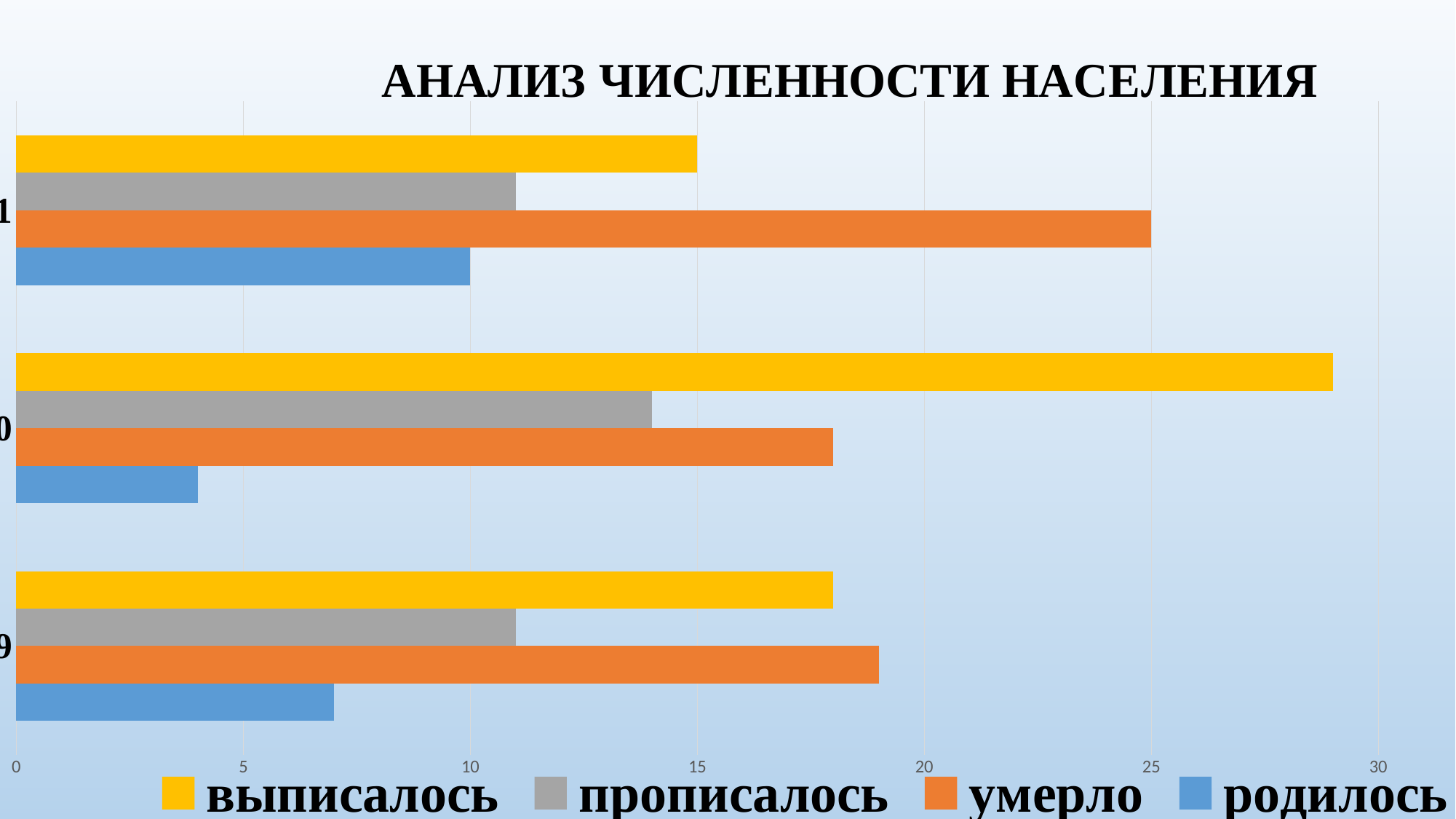
In the middle group of bars, is the value for 'родилось' greater or less than 5? less How many groups of bars (categories) are plotted on the chart? 3 What is the title of the chart? АНАЛИЗ ЧИСЛЕННОСТИ НАСЕЛЕНИЯ How many series does the legend list? 4 Which colour represents the series 'умерло' in the legend? orange What kind of chart is shown on the slide? bar chart In the top group of bars, which series has the highest value? умерло In the top group of bars, what is the value for 'родилось'? 10 In the middle group of bars, which is larger: 'выписалось' or 'умерло'? выписалось In the middle group of bars, is the value for 'выписалось' greater or less than 25? greater In the top group of bars, what is the value for 'умерло'? 25 In the top group of bars, what is the value for 'выписалось'? 15